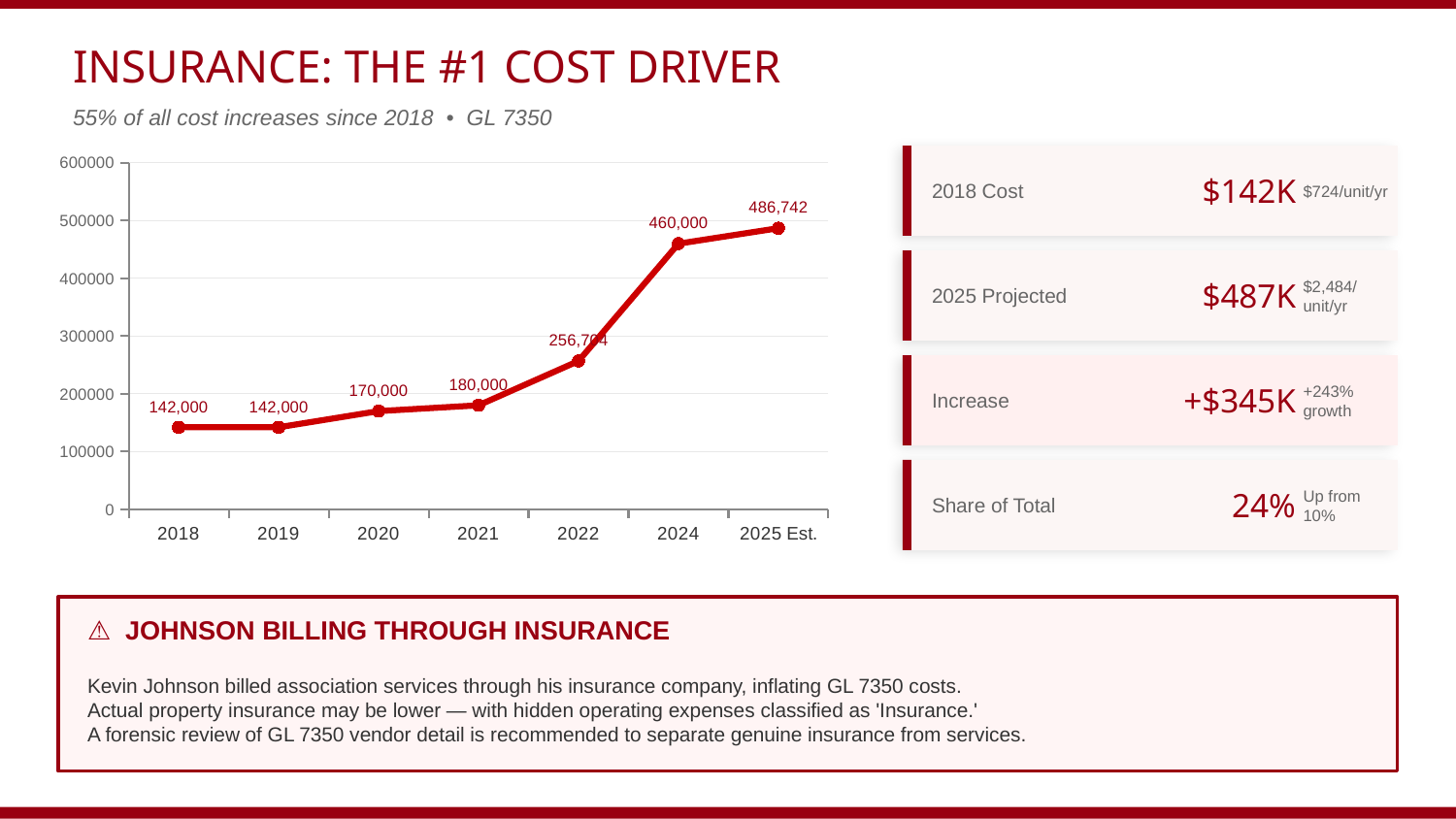
What is the value plotted for 2024? 460,000 What kind of chart is shown on the slide? line chart What is the value plotted for 2018? 142,000 What is the value plotted for 2025 Est.? 486,742 What is the difference between the values for 2025 Est. and 2024? 26,742 Do the plotted values generally rise or fall from 2018 to 2025 Est.? rise Is the value for 2022 greater or less than 200000? greater How many data points are plotted on the line? 7 Which is larger, the value for 2021 or the value for 2020? 2021 What is the difference between the values for 2024 and 2021? 280,000 What is the value plotted for 2020? 170,000 Which year has the highest plotted value? 2025 Est.